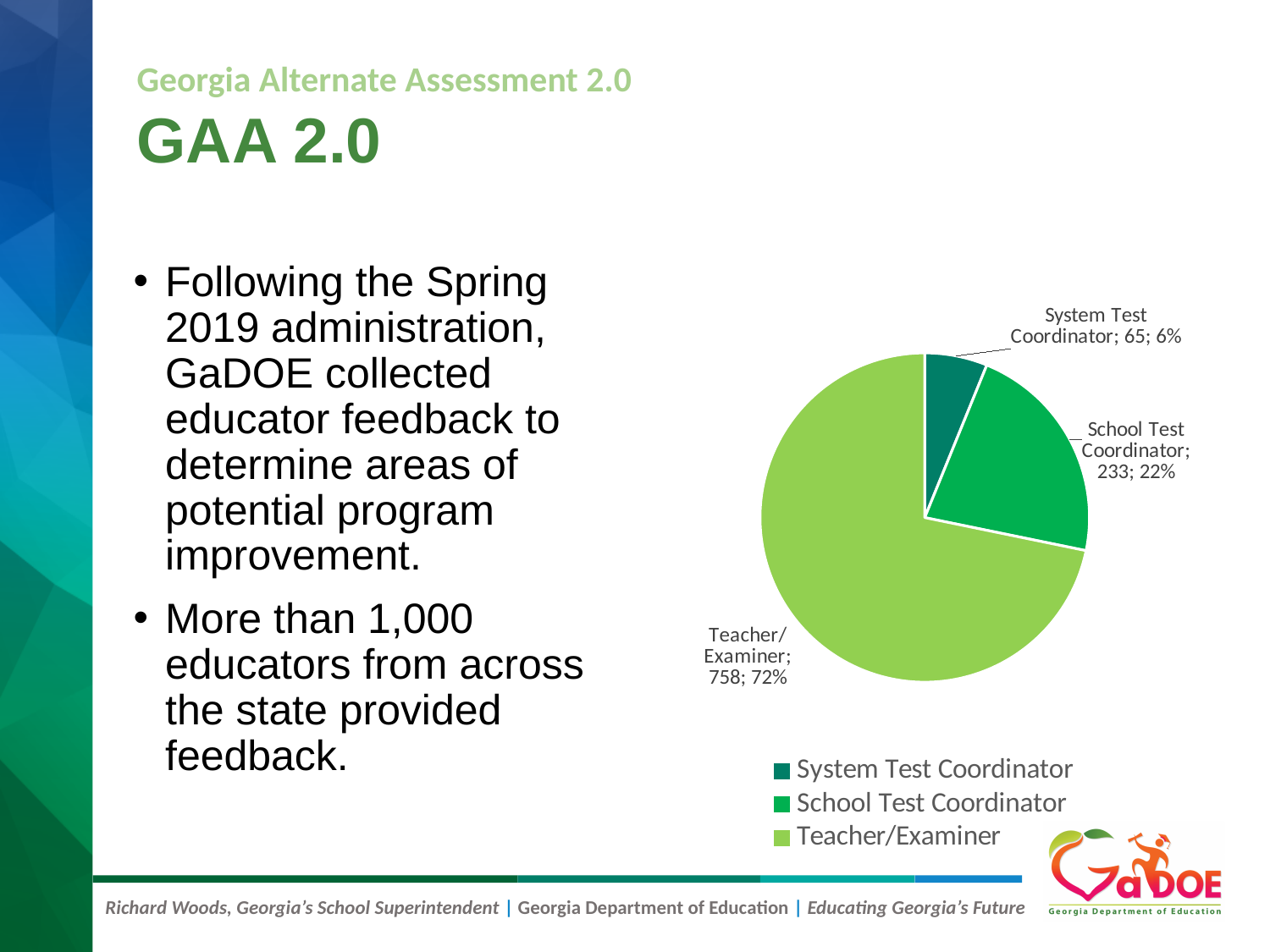
How many School Test Coordinator respondents does the pie chart show? 233 Which has more respondents, School Test Coordinator or System Test Coordinator? School Test Coordinator Which category has the largest slice of the pie chart? Teacher/Examiner What kind of chart is shown on the slide? pie chart What percentage of respondents were System Test Coordinators? 6% How many categories are shown in the pie chart? 3 What is the difference in count between School Test Coordinator and System Test Coordinator respondents? 168 Which category has the smallest slice of the pie chart? System Test Coordinator What is the total number of respondents across all three slices of the pie chart? 1,056 What share of the pie does Teacher/Examiner represent? 72% How many educators were Teacher/Examiner respondents according to the pie chart? 758 How many entries does the legend list? 3